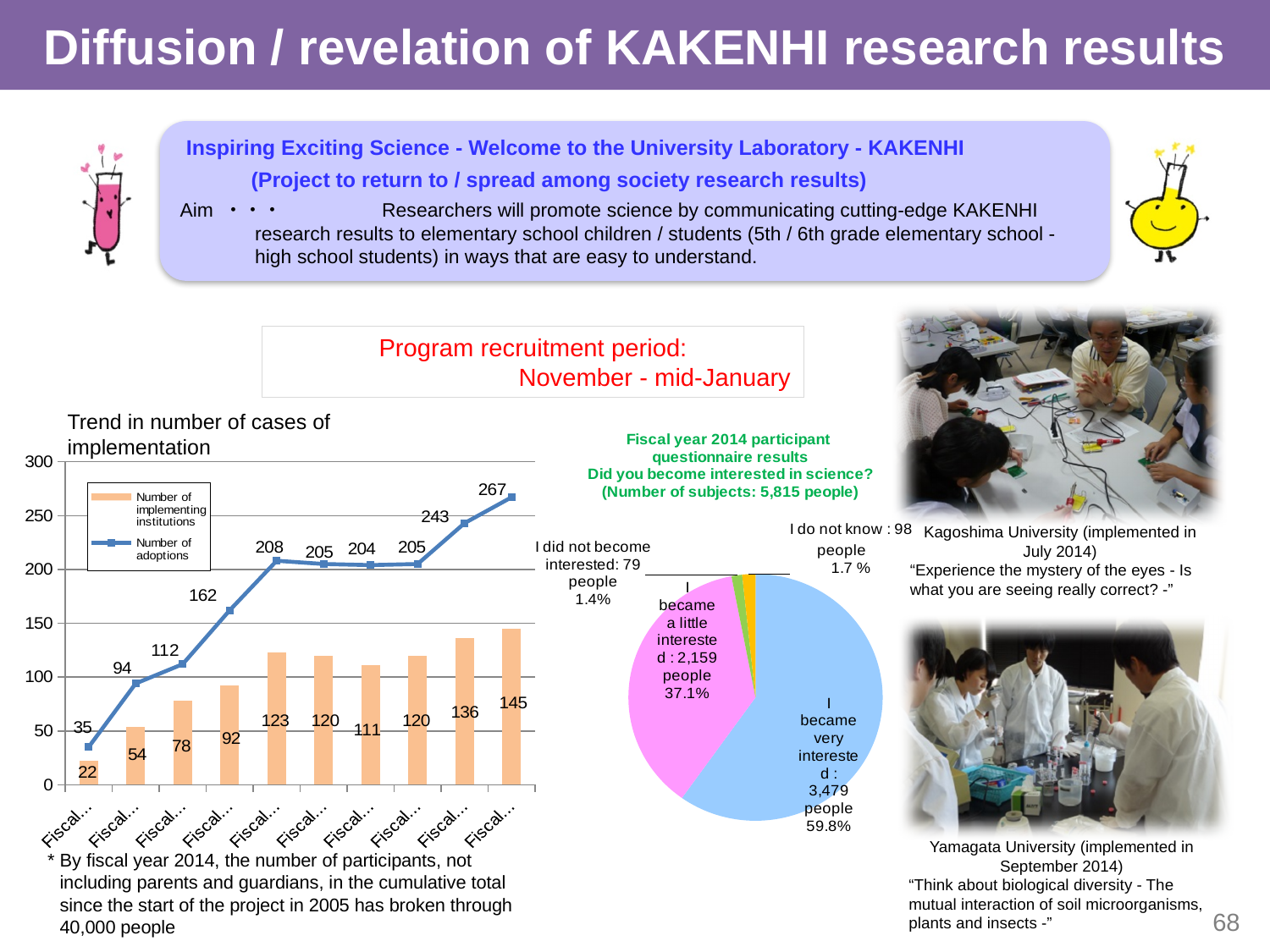
In the 'Fiscal year 2014 participant questionnaire results' pie chart, how many people said 'I became a little interested'? 2,159 people In the 'Trend in number of cases of implementation' chart, how many series does the legend list? 2 In the 'Trend in number of cases of implementation' chart, what is the difference between the last two values of the Number of adoptions series (267 and 243)? 24 In the 'Trend in number of cases of implementation' chart, for the first fiscal year, which is larger: the Number of implementing institutions or the Number of adoptions? Number of adoptions According to the title of the 'Fiscal year 2014 participant questionnaire results' pie chart, how many subjects answered the questionnaire? 5,815 people In the 'Trend in number of cases of implementation' chart, how many fiscal years are plotted along the x axis? 10 In the 'Trend in number of cases of implementation' chart, what is the highest value of the Number of adoptions series? 267 In the 'Fiscal year 2014 participant questionnaire results' pie chart, which response has the smallest slice? I did not become interested In the 'Trend in number of cases of implementation' chart, what is the lowest value of the Number of implementing institutions series? 22 In the 'Trend in number of cases of implementation' chart, does the Number of adoptions series generally rise or fall from the first fiscal year to the last? Rise What kind of chart is the 'Trend in number of cases of implementation' chart? A combined bar and line chart In the 'Fiscal year 2014 participant questionnaire results' pie chart, what share of respondents said 'I became very interested'? 59.8%